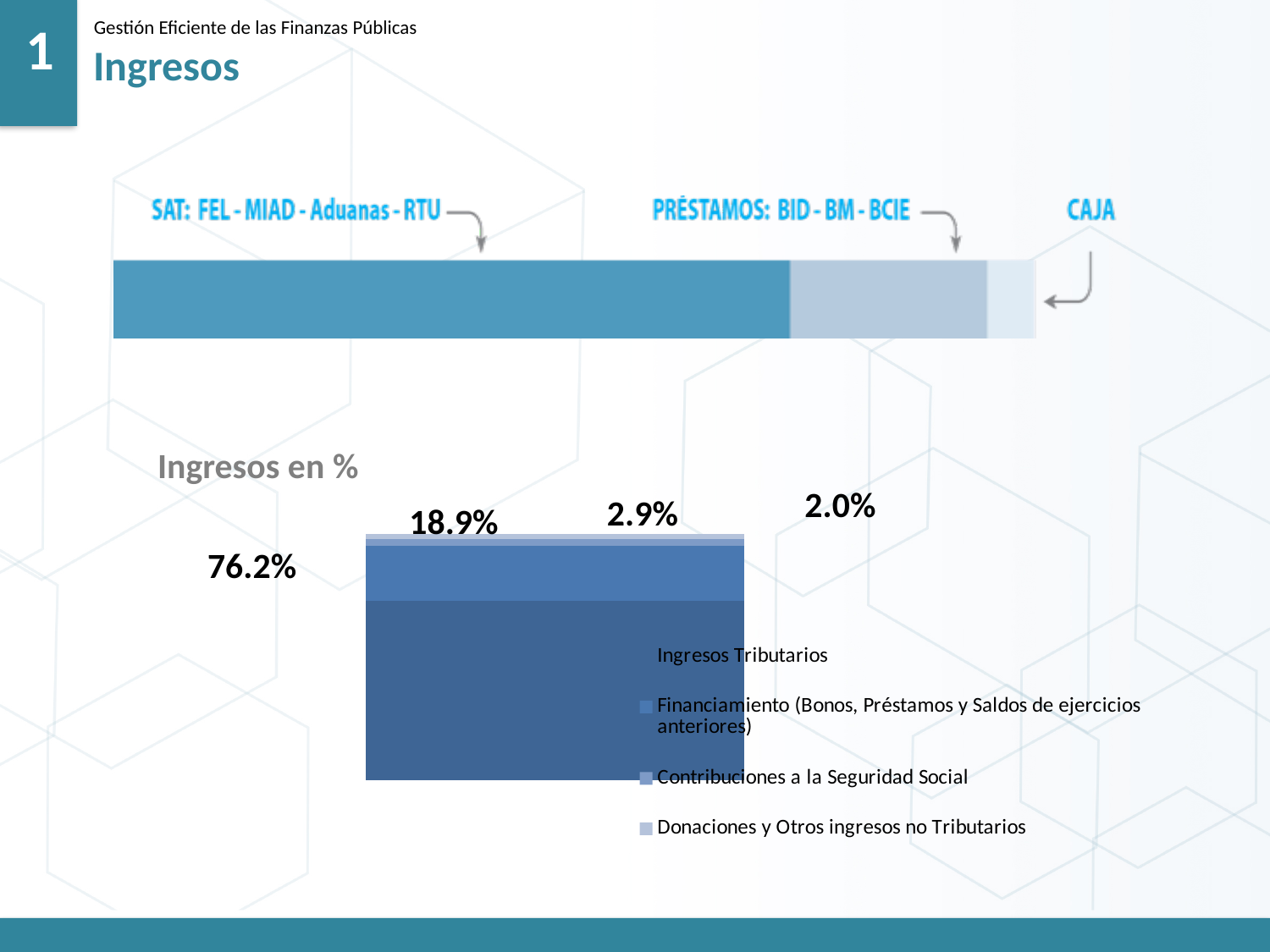
In the 'Ingresos en %' chart, which category has the largest share? Ingresos Tributarios What kind of chart is 'Ingresos en %'? Stacked bar chart What is the title of the chart on the slide? Ingresos en % What is the total of all segments in the 'Ingresos en %' stacked bar? 100.0% In the 'Ingresos en %' chart, what percentage is shown for Ingresos Tributarios? 76.2% In the 'Ingresos en %' chart, what percentage is shown for Donaciones y Otros ingresos no Tributarios? 2.0% In the 'Ingresos en %' chart, what percentage is shown for Financiamiento (Bonos, Préstamos y Saldos de ejercicios anteriores)? 18.9% In the 'Ingresos en %' chart, which is larger: Financiamiento or Contribuciones a la Seguridad Social? Financiamiento In the 'Ingresos en %' chart, what is the difference in percentage points between Ingresos Tributarios and Financiamiento? 57.3 How many series does the legend of the 'Ingresos en %' chart list? 4 In the 'Ingresos en %' chart, what percentage is shown for Contribuciones a la Seguridad Social? 2.9% In the 'Ingresos en %' chart, which category has the smallest share? Donaciones y Otros ingresos no Tributarios